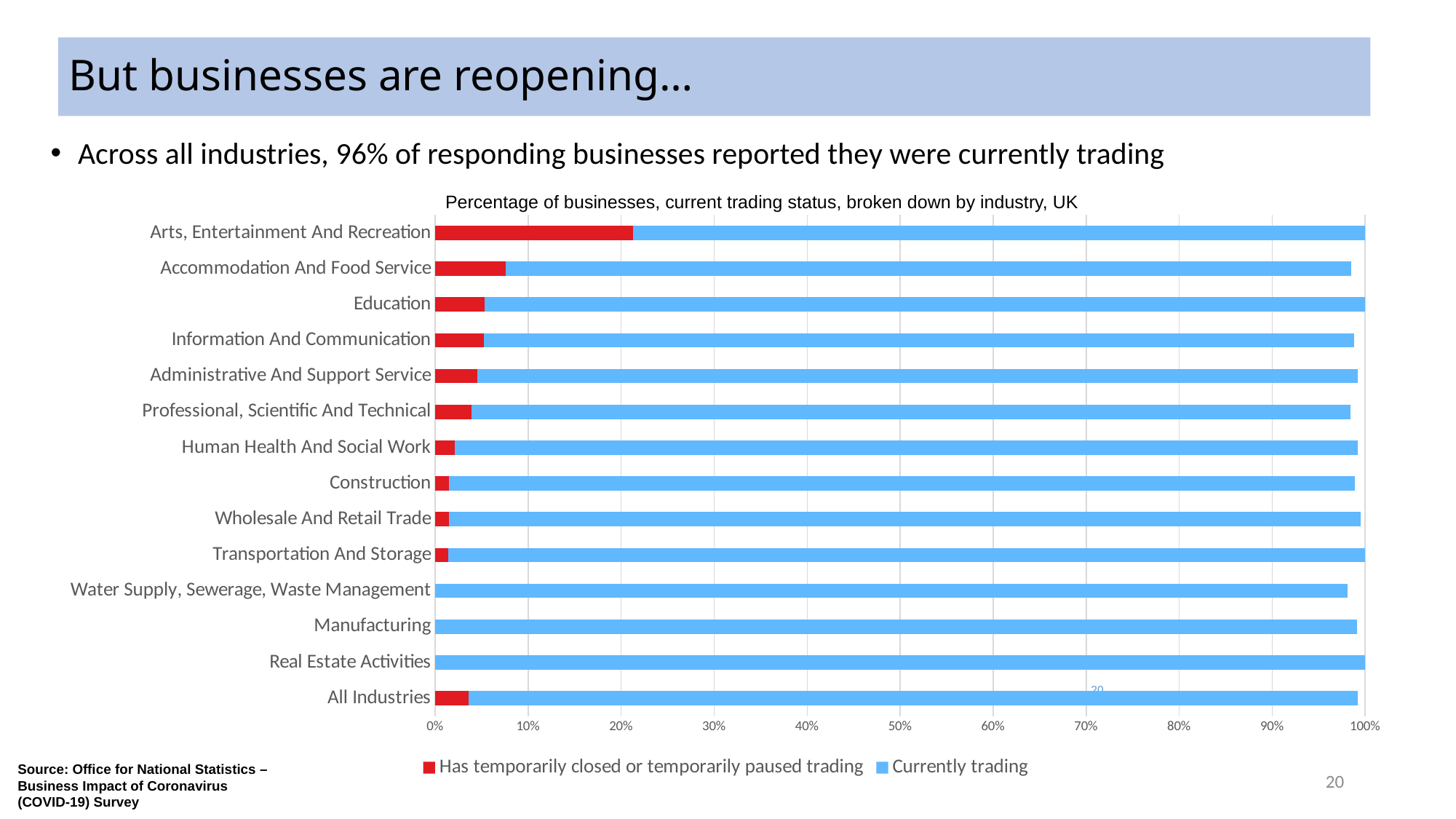
Which industry has the largest share of businesses that have temporarily closed or paused trading? Arts, Entertainment And Recreation What is the title of the chart? Percentage of businesses, current trading status, broken down by industry, UK How many series does the chart legend list? 2 Which has a larger share of businesses temporarily closed or paused trading: Accommodation And Food Service or Construction? Accommodation And Food Service Is the 'Has temporarily closed or temporarily paused trading' value for Arts, Entertainment And Recreation greater or less than 10%? greater What colour represents the 'Currently trading' series in the chart? Blue Is the 'Currently trading' value for Real Estate Activities greater or less than 90%? greater How many industry categories are plotted on the chart? 14 Is the 'Has temporarily closed or temporarily paused trading' value for Education greater or less than 10%? less What kind of chart is shown on the slide? Bar chart Which has a larger share of businesses temporarily closed or paused trading: Arts, Entertainment And Recreation or Accommodation And Food Service? Arts, Entertainment And Recreation